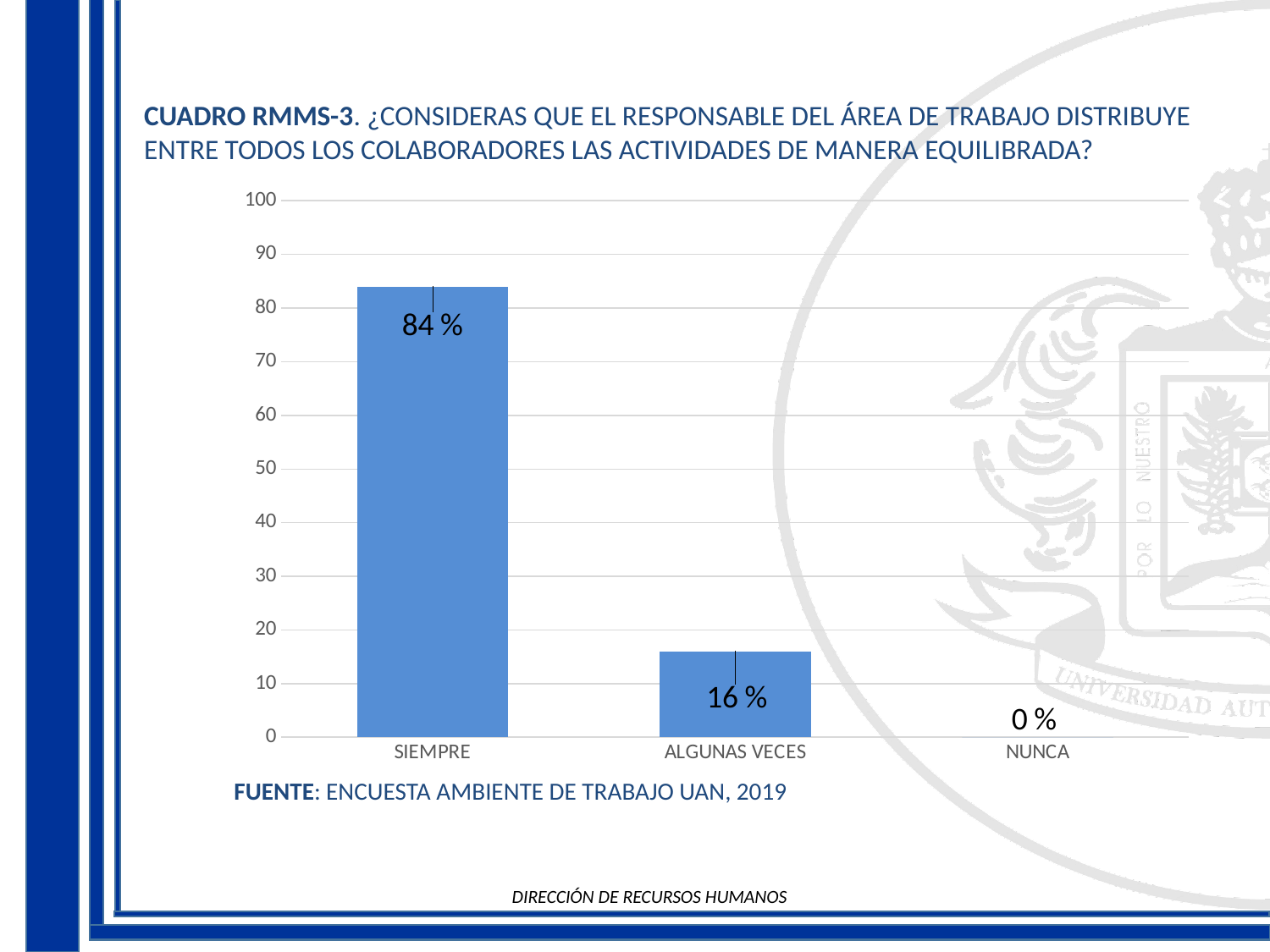
What is the value for SIEMPRE? 84 % What is the value for ALGUNAS VECES? 16 % What source is cited below the chart? ENCUESTA AMBIENTE DE TRABAJO UAN, 2019 How many categories are shown on the x axis? 3 Which category has the lowest value? NUNCA Is the value for SIEMPRE greater or less than 80? greater Is the value for ALGUNAS VECES greater or less than 20? less What is the value for NUNCA? 0 % What is the difference between the values for SIEMPRE and ALGUNAS VECES? 68 % Which is larger, the value for ALGUNAS VECES or the value for NUNCA? ALGUNAS VECES What kind of chart is shown on the slide? bar chart Which category has the highest value? SIEMPRE